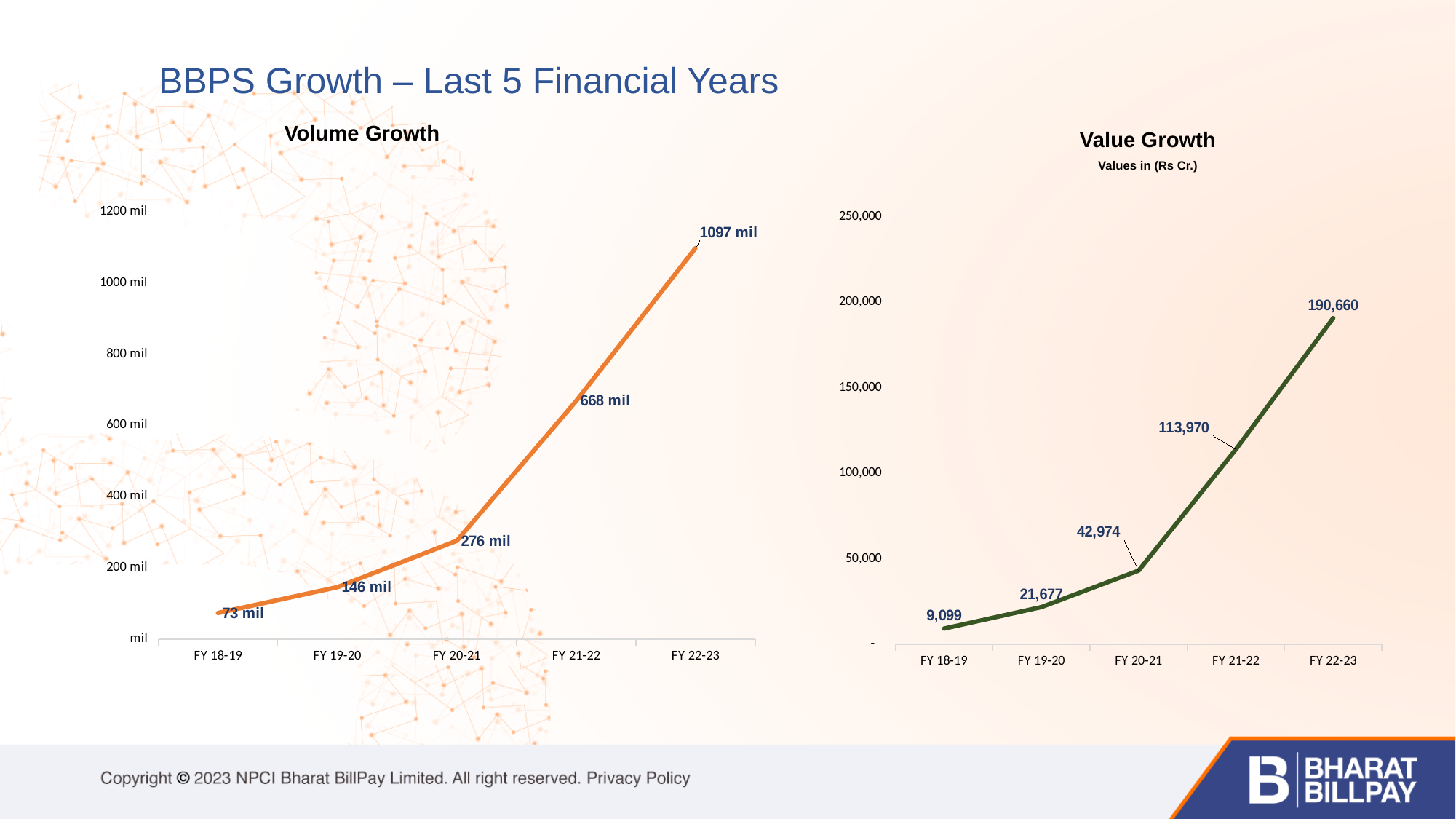
In the Value Growth chart, which financial year has the highest value? FY 22-23 In the Volume Growth chart, do the values rise or fall from FY 18-19 to FY 22-23? Rise In the Value Growth chart, what is the difference between the FY 19-20 and FY 18-19 values? 12,578 In the Value Growth chart, what is the value for FY 22-23? 190,660 In the Volume Growth chart, what is the value for FY 18-19? 73 mil What kind of chart is the Value Growth chart? Line chart In the Value Growth chart, what is the value for FY 20-21? 42,974 In the Volume Growth chart, what is the difference between the FY 22-23 and FY 21-22 values? 429 mil How many financial years are plotted in the Volume Growth chart? 5 In the Volume Growth chart, what is the value for FY 22-23? 1097 mil In the Value Growth chart, which is larger, the value for FY 21-22 or FY 20-21? FY 21-22 In the Volume Growth chart, which financial year has the lowest value? FY 18-19